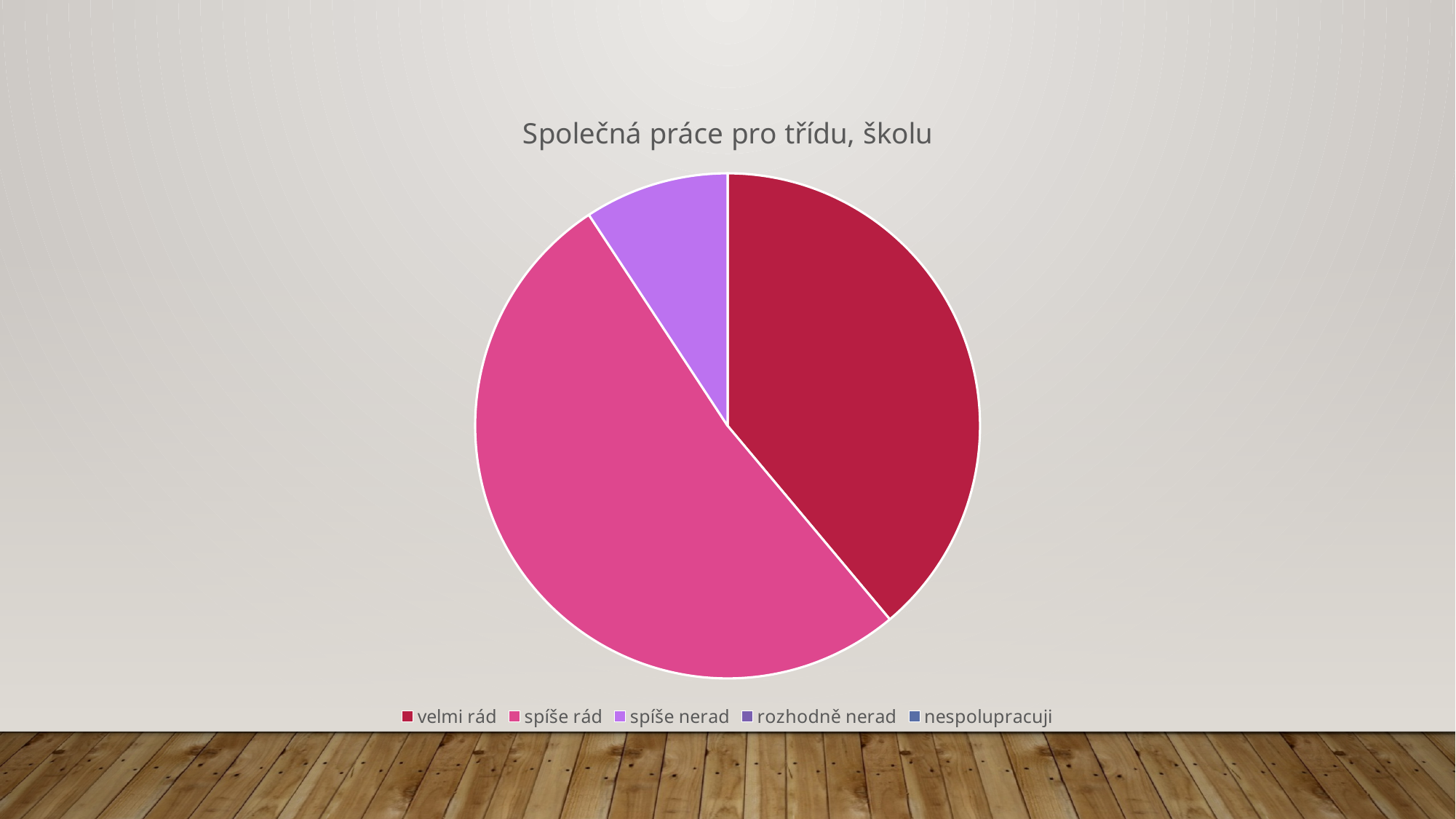
What is the title of the chart? Společná práce pro třídu, školu Which slice is larger, velmi rád or spíše nerad? velmi rád What kind of chart is shown on the slide? pie chart Which slice is larger, spíše rád or velmi rád? spíše rád How many entries does the chart's legend list? 5 How many slices are visible in the pie? 3 Which of the visible slices is the smallest? spíše nerad Which legend entry is shown in light purple? spíše nerad Which category has the largest slice of the pie? spíše rád